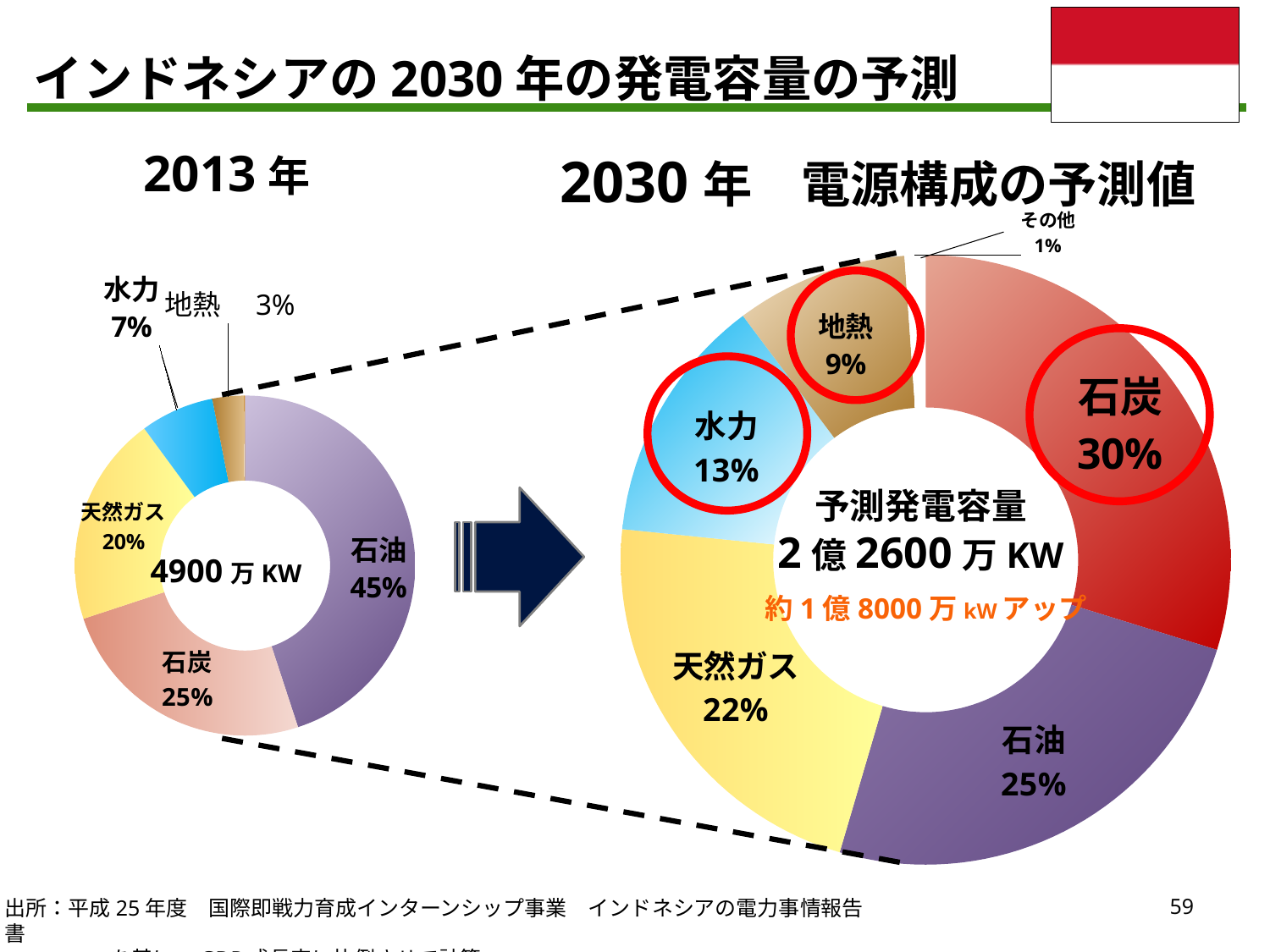
In the 2013 chart on the left, which category has the largest share? 石油 What total generation capacity is printed in the centre of the 2030 chart on the right? 2億2600万KW In the 2030 chart on the right, which category has the smallest share? その他 In the 2030 chart on the right, which category has the largest share? 石炭 In the 2013 chart on the left, what share does 石油 have? 45% In the 2030 chart on the right, what share does 水力 have? 13% In the 2013 chart on the left, what is the difference between the shares of 石油 and 石炭? 20% How many categories are shown in the 2030 chart on the right? 6 In the 2030 chart on the right, which is larger, the share of 天然ガス or the share of 水力? 天然ガス In the 2030 chart on the right, what share does 石炭 have? 30% What kind of chart is used for the 2013 data on the left? Donut (pie) chart What total generation capacity is printed in the centre of the 2013 chart on the left? 4900万KW